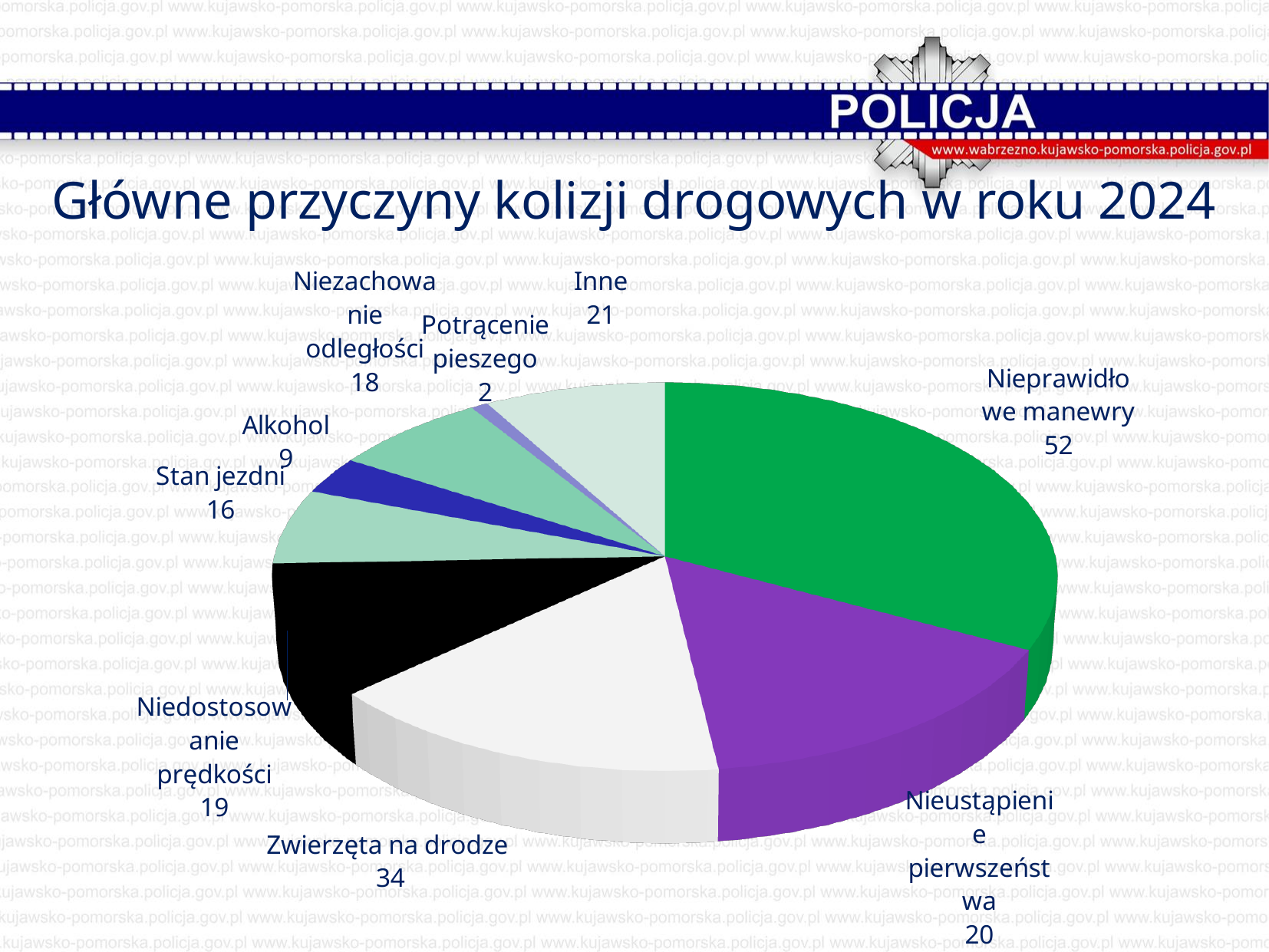
What is the value for Zwierzęta na drodze? 34 Which category has the lowest value? Potrącenie pieszego What is the value for Nieprawidłowe manewry? 52 What type of chart is shown on the slide? pie chart What is the value for Alkohol? 9 What is the title of the chart? Główne przyczyny kolizji drogowych w roku 2024 What is the difference between the values for Nieprawidłowe manewry and Zwierzęta na drodze? 18 Which has a larger value, Inne or Nieustąpienie pierwszeństwa? Inne How many categories are shown in the pie chart? 9 Which category has the highest value? Nieprawidłowe manewry What is the value for Stan jezdni? 16 What is the difference between the values for Niedostosowanie prędkości and Niezachowanie odległości? 1